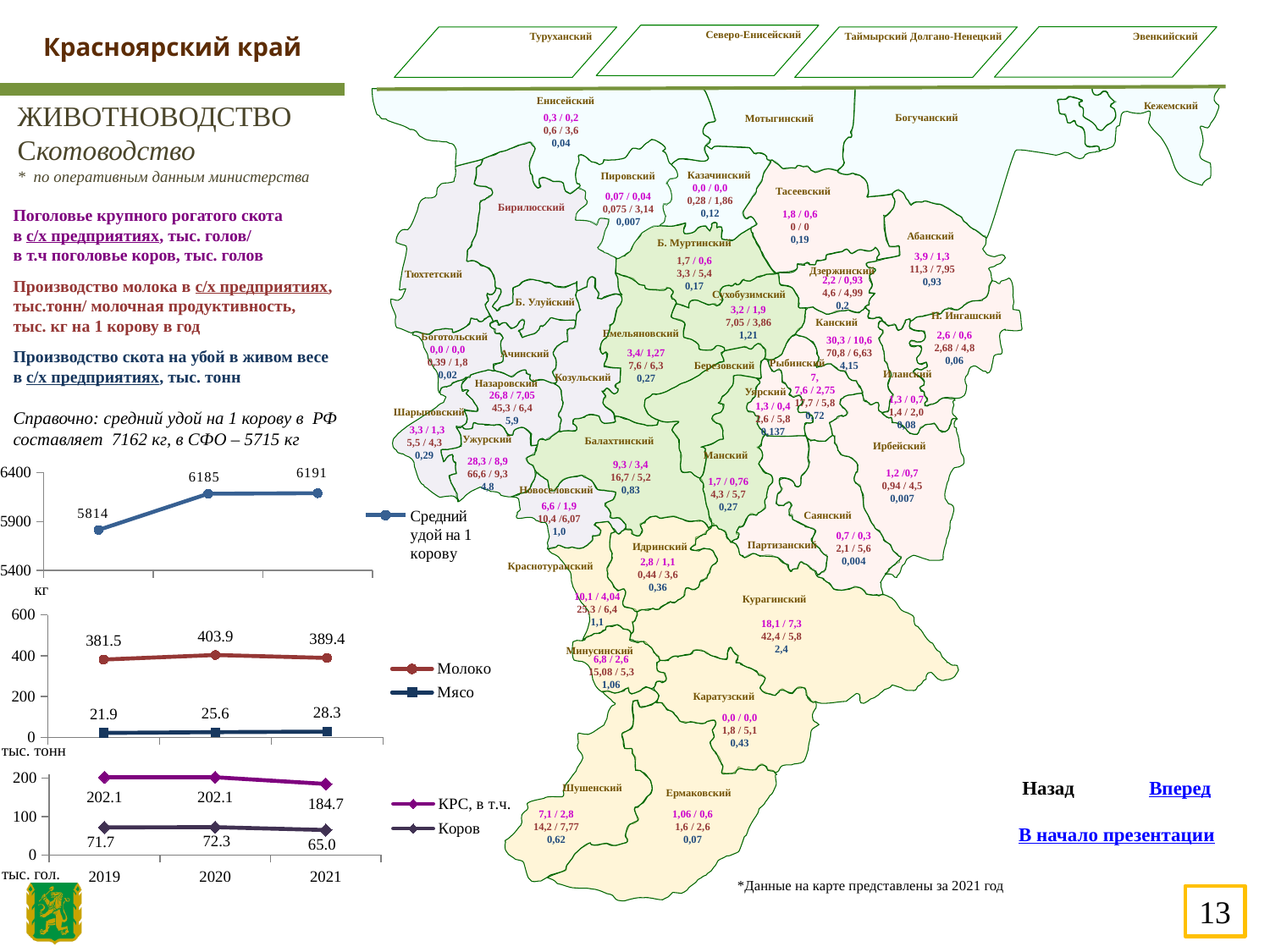
In the top line chart on the left (Средний удой на 1 корову), what is the difference between the 2020 and 2019 values? 371 In the bottom line chart on the left, what is the difference between КРС, в т.ч. and Коров in 2019? 130.4 In the top line chart on the left (Средний удой на 1 корову), which year has the highest value? 2021 In the middle line chart on the left, what is the value of Мясо for 2021? 28.3 In the middle line chart on the left, what is the value of Молоко for 2020? 403.9 In the middle line chart on the left, how many series does the legend list? 2 In the top line chart on the left (Средний удой на 1 корову), what is the value for 2019? 5814 What type of chart is the top chart on the left (Средний удой на 1 корову)? line chart In the bottom line chart on the left, what is the value of Коров for 2020? 72.3 In the bottom line chart on the left, which year has the lowest value for Коров? 2021 In the middle line chart on the left, does the Мясо series rise or fall from 2019 to 2021? rises In the bottom line chart on the left, what is the value of КРС, в т.ч. for 2021? 184.7